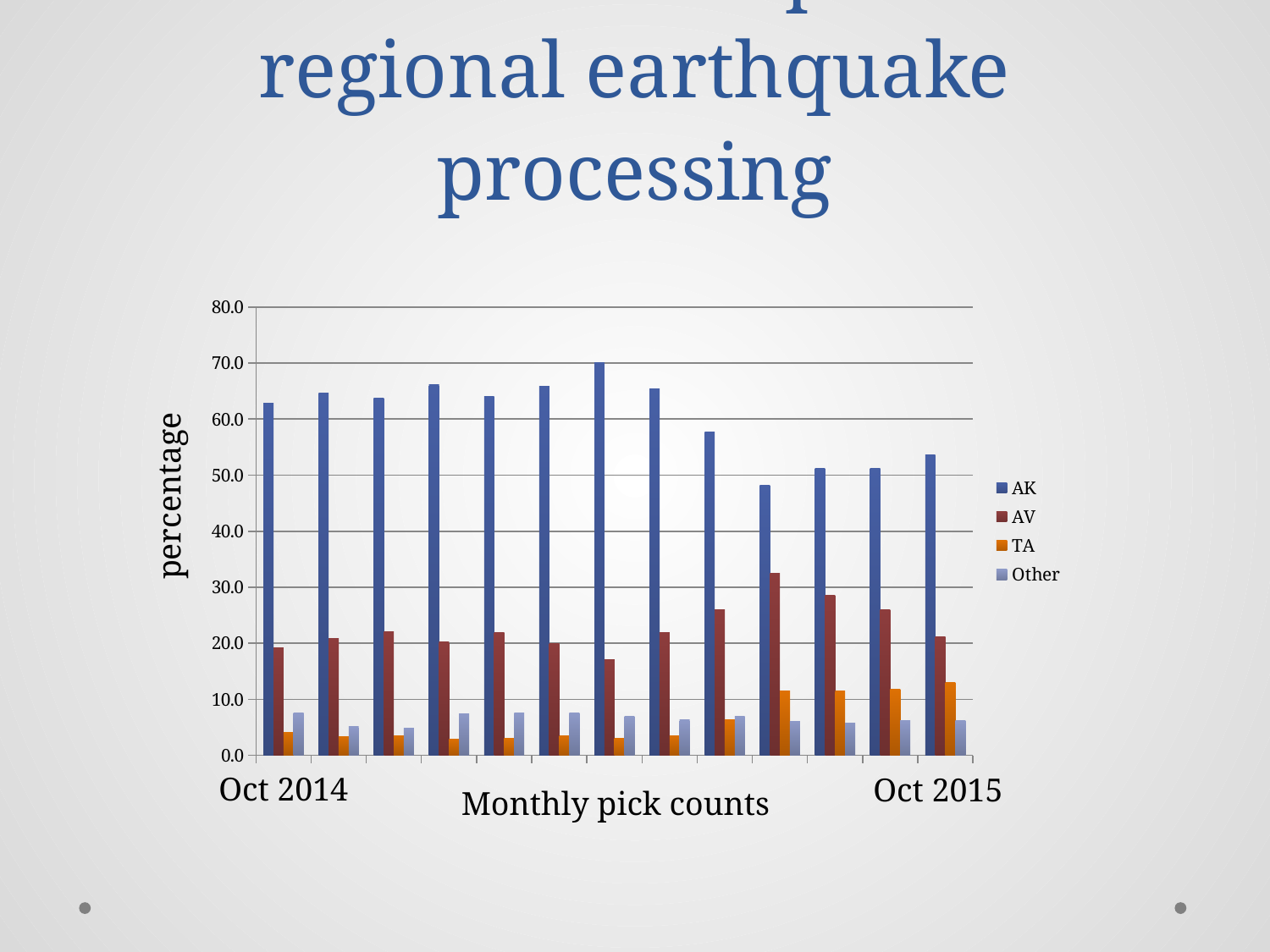
Is the value for TA in Oct 2015 greater or less than 10.0? greater Which series has the highest value in Oct 2014? AK Is the value for AK in Oct 2014 greater or less than 60.0? greater What is the label on the vertical axis of the chart? percentage How many monthly groups of bars are plotted in the chart? 13 How many series does the legend list? 4 Is the value for Other in Oct 2014 greater or less than 10.0? less Which is larger, the AK value in Oct 2014 or the AK value in Oct 2015? Oct 2014 Do the AK values generally rise or fall from Oct 2014 to Oct 2015? fall What kind of chart is shown on the slide? bar chart Which series has the lowest value in Oct 2014? TA